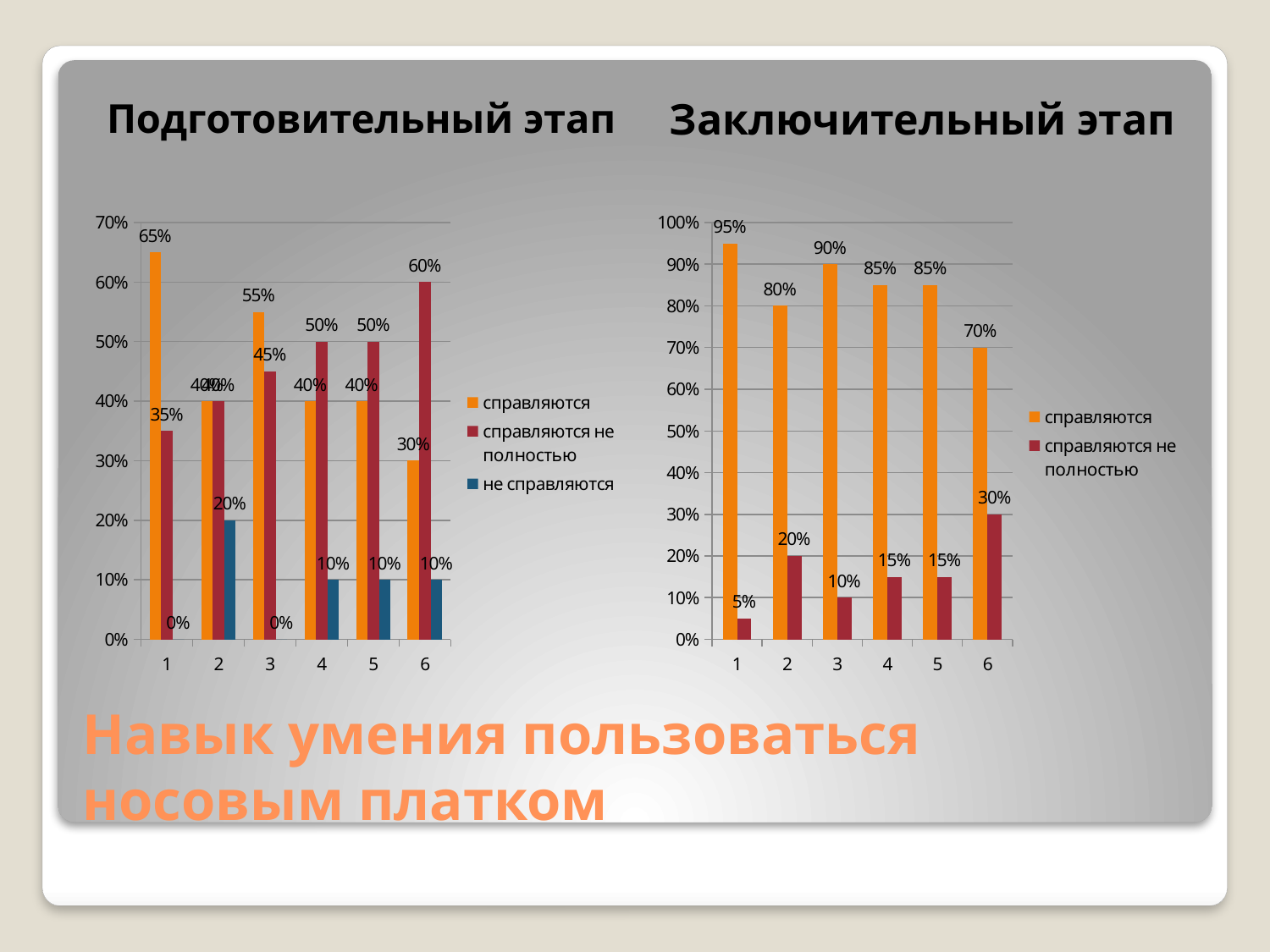
How many series does the legend of the Подготовительный этап chart list? 3 What type of chart is the Заключительный этап chart? bar chart What is the title of the chart on the left side of the slide? Подготовительный этап In the Заключительный этап chart, is the value of справляются for category 2 greater or less than 70%? greater In the Подготовительный этап chart, do the values of справляются не полностью rise or fall from category 3 to category 6? rise In the Подготовительный этап chart, which is larger for category 6: справляются or справляются не полностью? справляются не полностью In the Подготовительный этап chart, what is the value of справляются for category 1? 65% In the Заключительный этап chart, what is the value of справляются не полностью for category 6? 30% In the Подготовительный этап chart, which category has the lowest value for справляются? 6 How many categories are shown on the x axis of the Заключительный этап chart? 6 In the Заключительный этап chart, what is the difference between the справляются values for category 1 and category 6? 25% In the Заключительный этап chart, which category has the highest value for справляются? 1